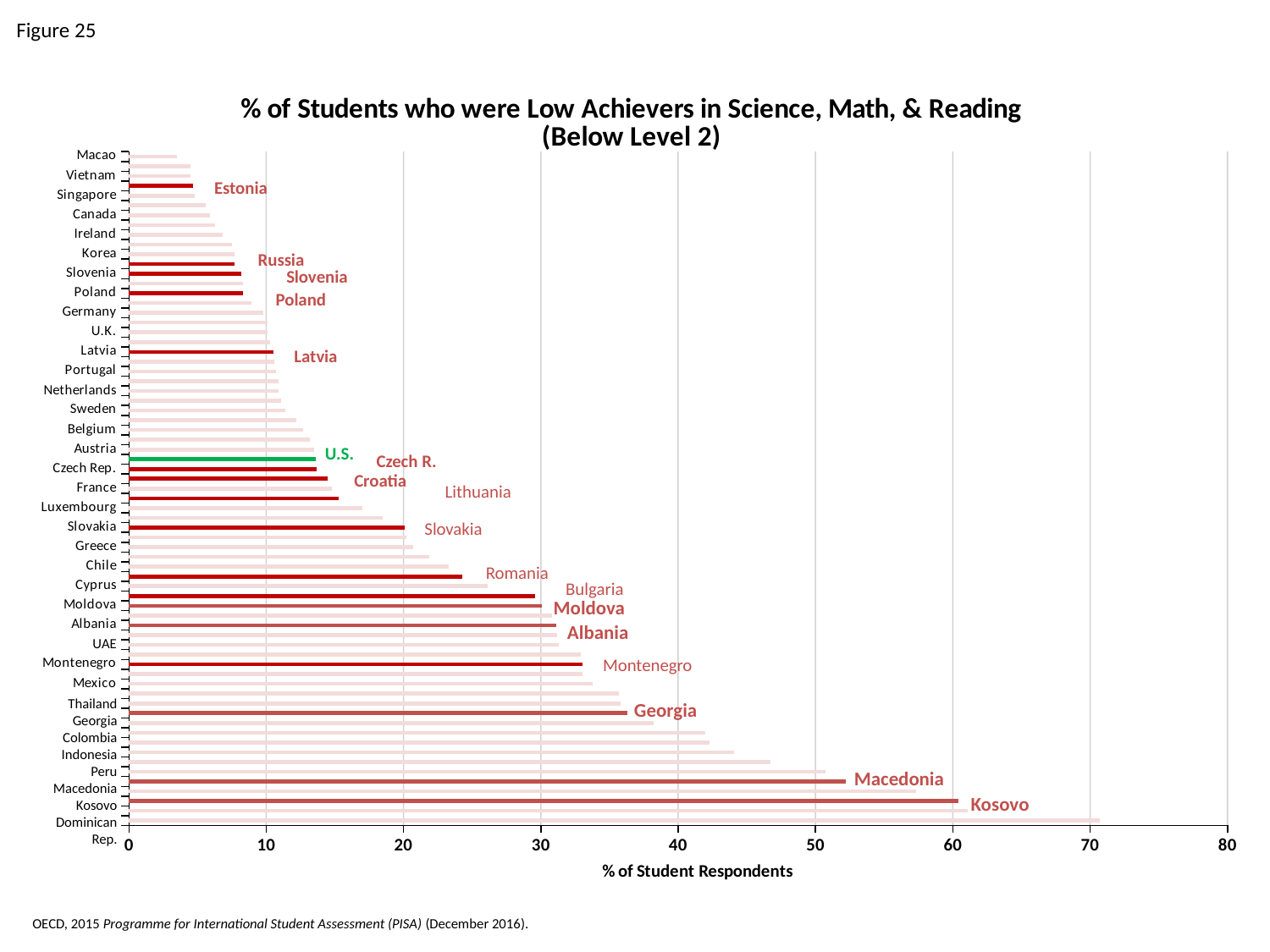
Which has a higher percentage of low achievers, the U.S. or Estonia? U.S. Is the value for Estonia greater or less than 10? less What is the label of the horizontal axis? % of Student Respondents Is the value for Georgia greater or less than 30? greater Which country's bar is highlighted in green? U.S. Which country has the highest percentage of low achievers? Dominican Rep. Is the value for the U.S. greater or less than 20? less What kind of chart is shown on the slide? bar chart Which has a higher percentage of low achievers, Kosovo or Macedonia? Kosovo Which country has the lowest percentage of low achievers? Macao